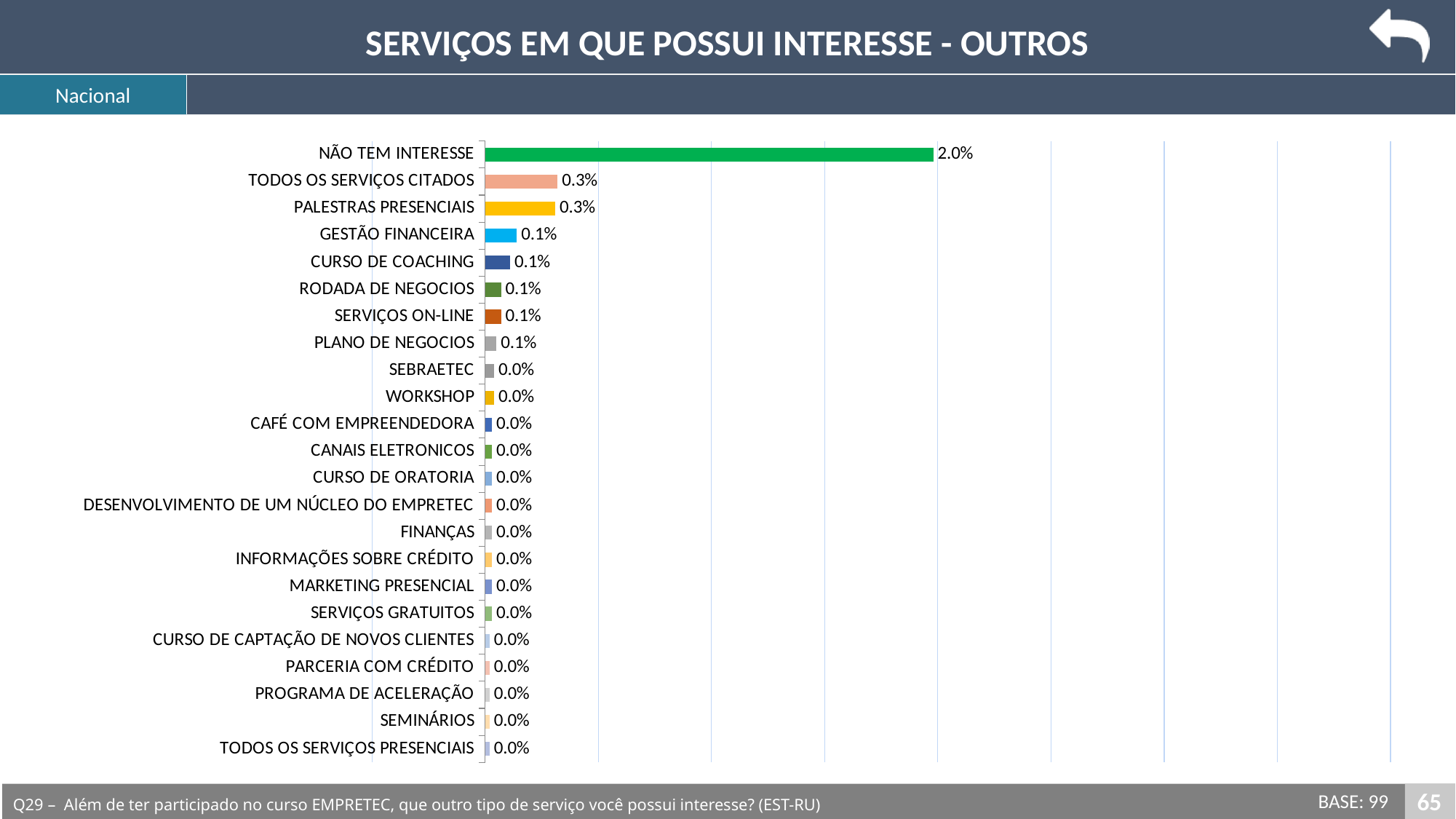
What is the value for SEBRAETEC? 0.0% What is the value for NÃO TEM INTERESSE? 2.0% What is the difference between the values for NÃO TEM INTERESSE and PALESTRAS PRESENCIAIS? 1.7% Which category has the highest value? NÃO TEM INTERESSE What is the value for PALESTRAS PRESENCIAIS? 0.3% What kind of chart is shown on the slide? bar chart What is the value for TODOS OS SERVIÇOS CITADOS? 0.3% What is the value for GESTÃO FINANCEIRA? 0.1% Which is larger, the value for PALESTRAS PRESENCIAIS or the value for RODADA DE NEGOCIOS? PALESTRAS PRESENCIAIS What is the title of the slide containing the chart? SERVIÇOS EM QUE POSSUI INTERESSE - OUTROS What is the difference between the values for TODOS OS SERVIÇOS CITADOS and CURSO DE COACHING? 0.2% How many categories are shown in the chart? 23